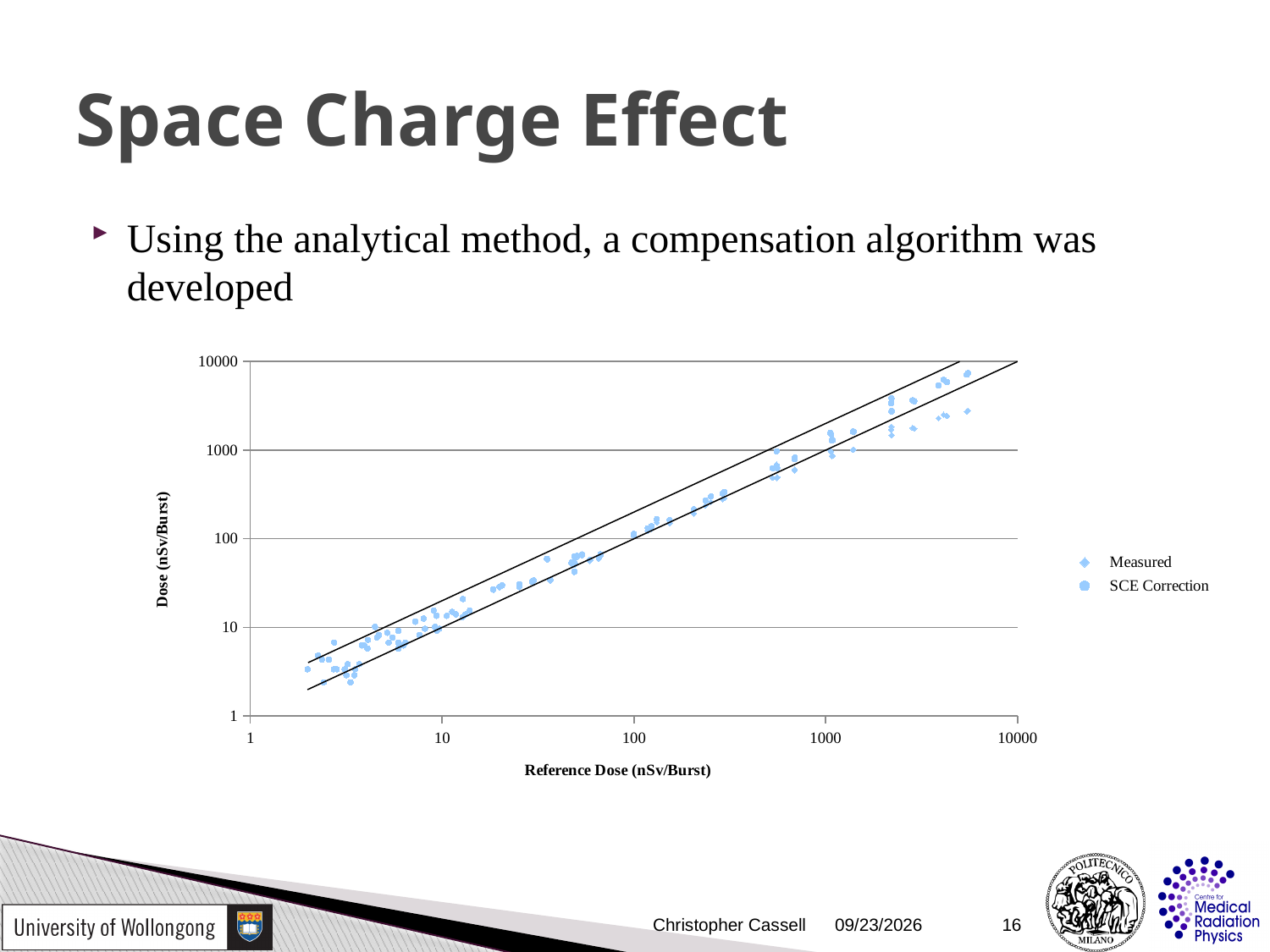
What is the highest tick value shown on the y axis of the chart? 10000 What kind of chart is shown on the slide? Scatter chart What is the lowest tick value shown on the x axis of the chart? 1 Do the plotted dose values rise or fall as the reference dose increases along the x axis? Rise Are the lowest plotted dose values on the chart greater or less than 10 nSv/Burst? less Are the highest plotted dose values on the chart greater or less than 1000 nSv/Burst? greater What is the title of the x axis of the chart? Reference Dose (nSv/Burst) What are the two series named in the chart legend? Measured and SCE Correction How many series does the chart legend list? 2